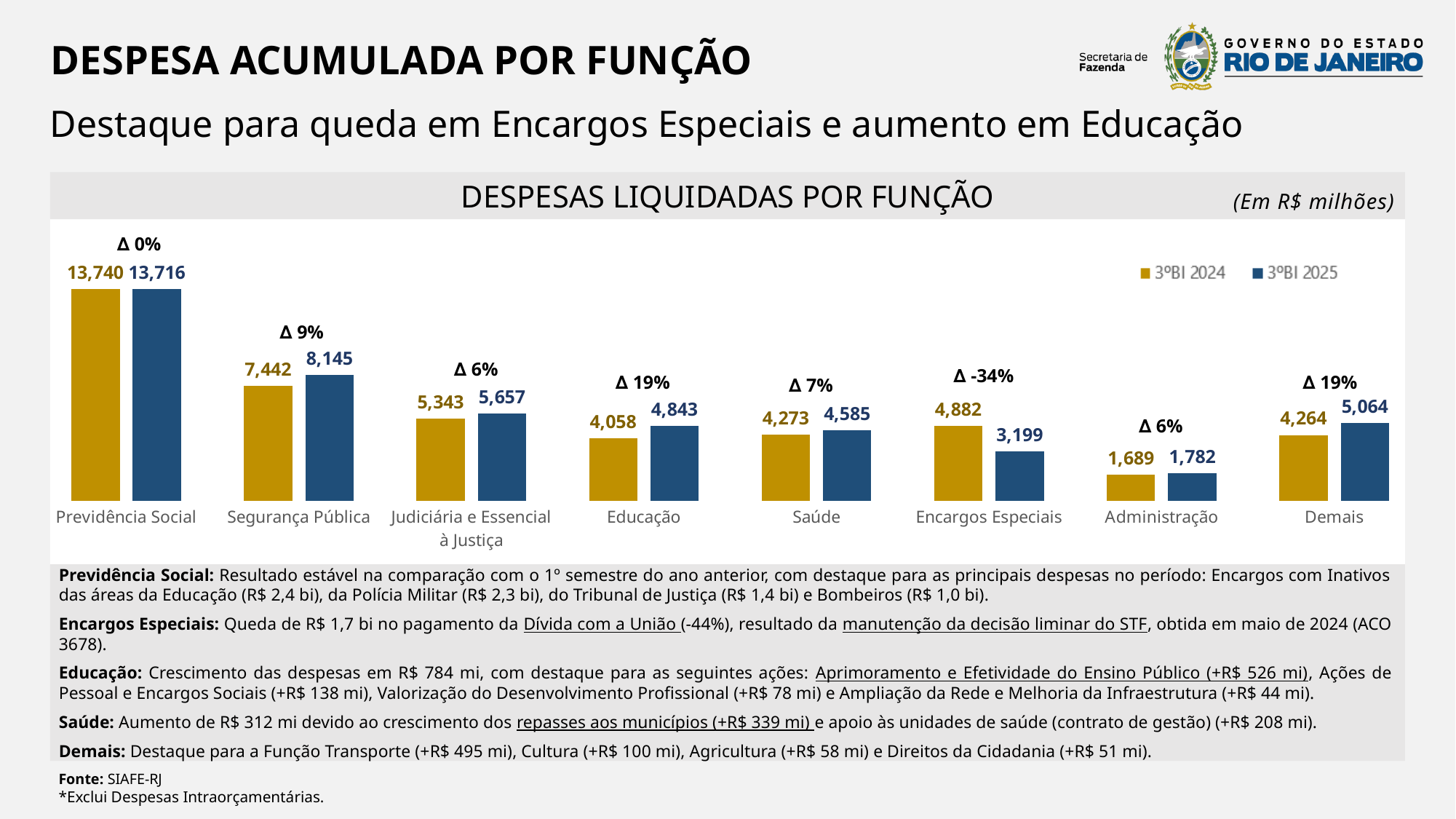
Which is larger for Saúde: the 3ºBI 2024 value or the 3ºBI 2025 value? 3ºBI 2025 How many series does the legend list? 2 What is the value for Educação in the 3ºBI 2025 series? 4,843 What percentage change (Δ) is shown above the bars for Encargos Especiais? -34% What is the value for Administração in the 3ºBI 2025 series? 1,782 Which category has the lowest value in the 3ºBI 2024 series? Administração What is the difference between the 3ºBI 2025 and 3ºBI 2024 values for Segurança Pública? 703 What is the value for Encargos Especiais in the 3ºBI 2024 series? 4,882 What is the difference between the 3ºBI 2024 and 3ºBI 2025 values for Encargos Especiais? 1,683 Which category has the highest value in the 3ºBI 2025 series? Previdência Social How many categories are shown on the x axis of the chart? 8 What kind of chart is shown on the slide? Bar chart